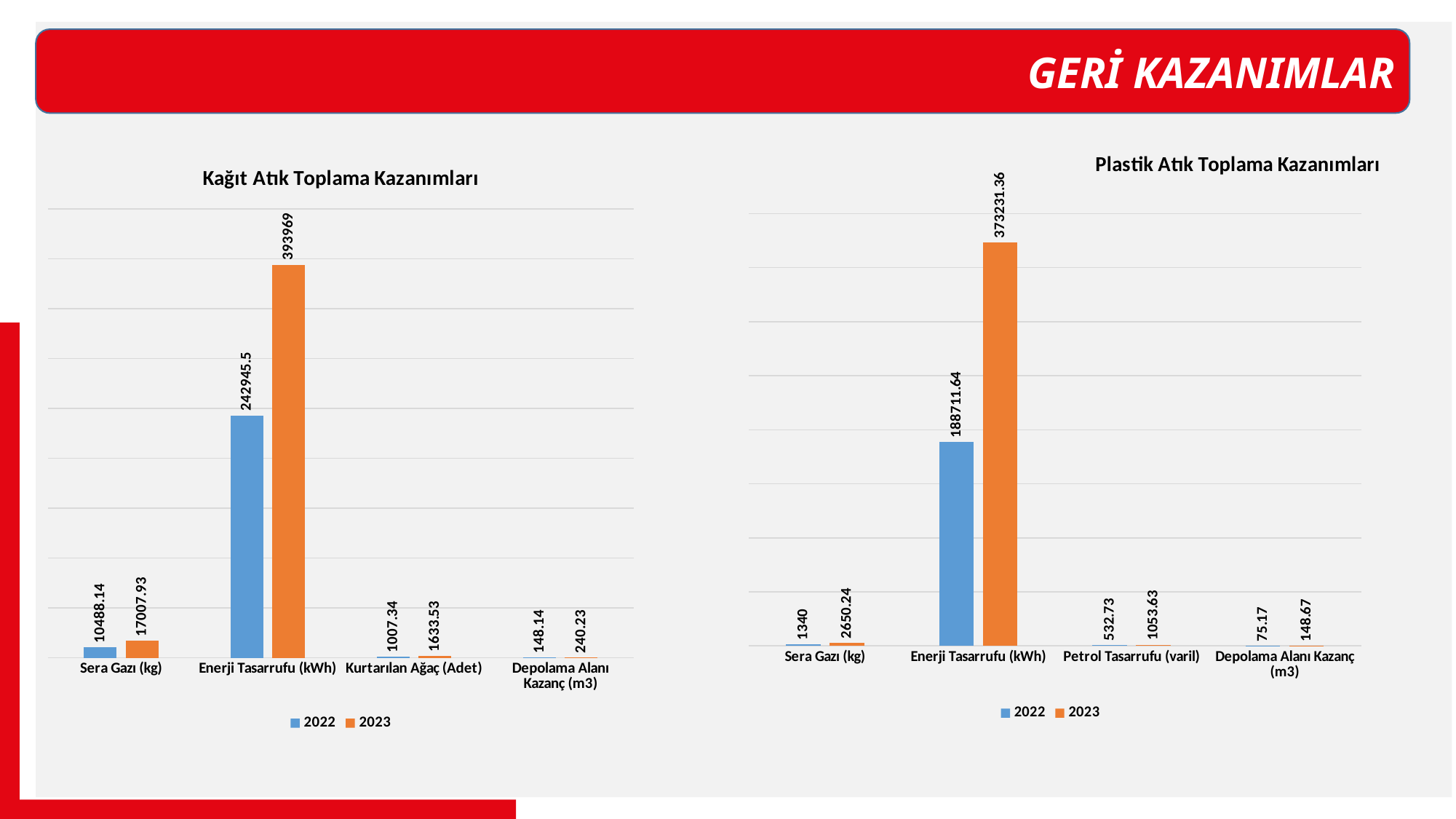
In the 'Plastik Atık Toplama Kazanımları' chart, which is larger for Enerji Tasarrufu (kWh): the 2022 value or the 2023 value? 2023 In the 'Kağıt Atık Toplama Kazanımları' chart, what is the 2023 value for Enerji Tasarrufu (kWh)? 393969 In the 'Kağıt Atık Toplama Kazanımları' chart, what is the 2022 value for Sera Gazı (kg)? 10488.14 In the 'Kağıt Atık Toplama Kazanımları' chart, what is the difference between the 2023 and 2022 values for Enerji Tasarrufu (kWh)? 151023.5 In the 'Plastik Atık Toplama Kazanımları' chart, what is the difference between the 2023 and 2022 values for Sera Gazı (kg)? 1310.24 In the 'Plastik Atık Toplama Kazanımları' chart, which category has the lowest 2022 value? Depolama Alanı Kazanç (m3) In the 'Plastik Atık Toplama Kazanımları' chart, what is the 2022 value for Depolama Alanı Kazanç (m3)? 75.17 How many series does the legend of the 'Plastik Atık Toplama Kazanımları' chart list? 2 How many categories are shown on the x axis of the 'Kağıt Atık Toplama Kazanımları' chart? 4 What type of chart is the 'Kağıt Atık Toplama Kazanımları' chart? Bar chart In the 'Kağıt Atık Toplama Kazanımları' chart, which category has the highest 2023 value? Enerji Tasarrufu (kWh) In the 'Plastik Atık Toplama Kazanımları' chart, what is the 2023 value for Petrol Tasarrufu (varil)? 1053.63